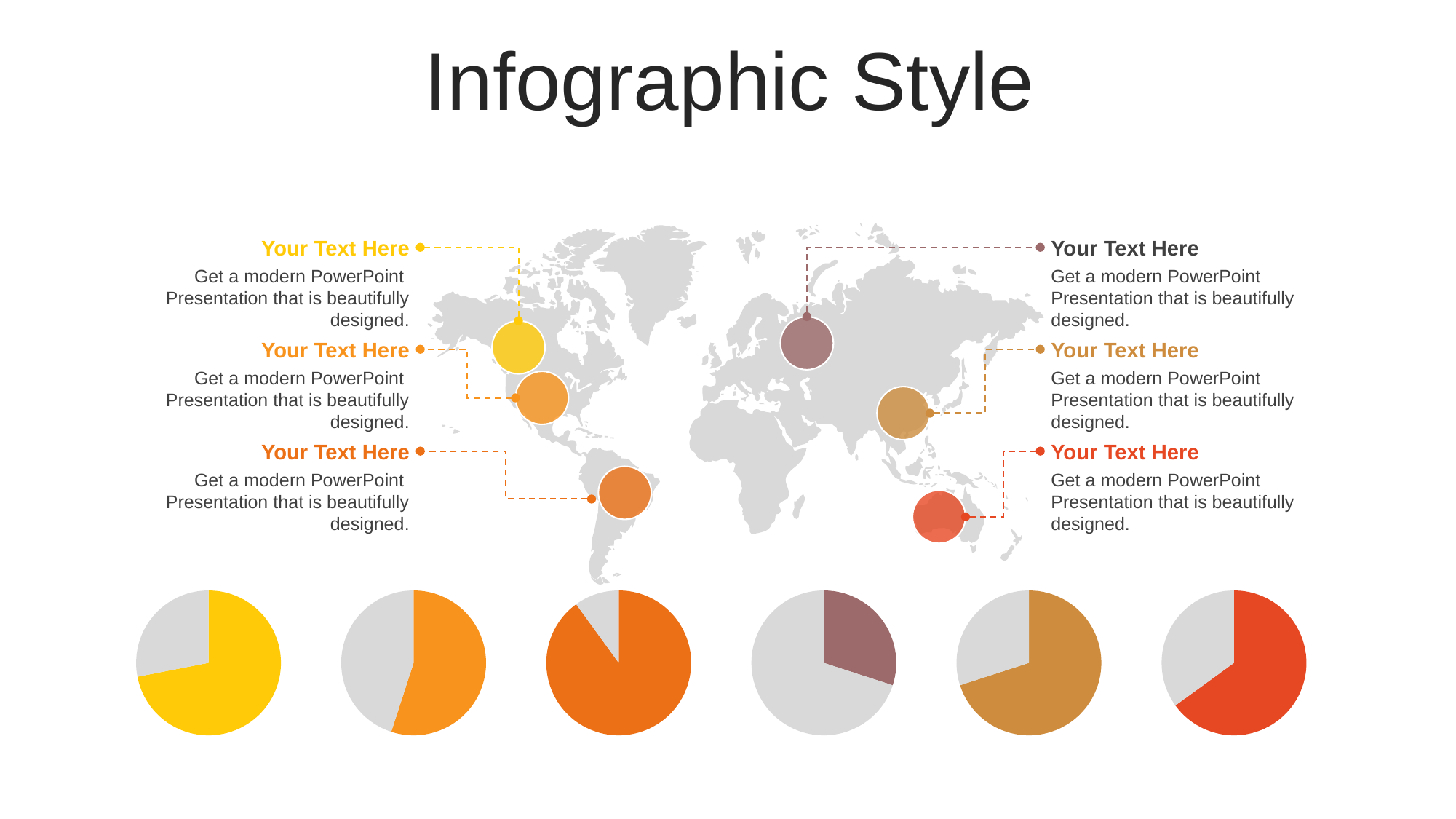
Which of the six pie charts has the smallest coloured slice? The fourth from the left (mauve) What colour is the highlighted slice of the rightmost pie chart? Red Which has the larger coloured slice: the fourth (mauve) pie or the fifth (brown) pie? The fifth (brown) pie What kind of charts are shown along the bottom of the slide? Pie charts How many pie charts are shown on the slide? 6 How many slices does each pie chart at the bottom of the slide have? 2 What colour is the highlighted slice of the leftmost pie chart? Yellow Which has the larger coloured slice: the third (dark orange) pie or the sixth (red) pie? The third (dark orange) pie Which of the six pie charts has the largest coloured slice? The third from the left (dark orange) Which has the larger coloured slice: the first (yellow) pie or the second (orange) pie? The first (yellow) pie Is the coloured share of the third pie chart from the left greater or less than 50%? greater